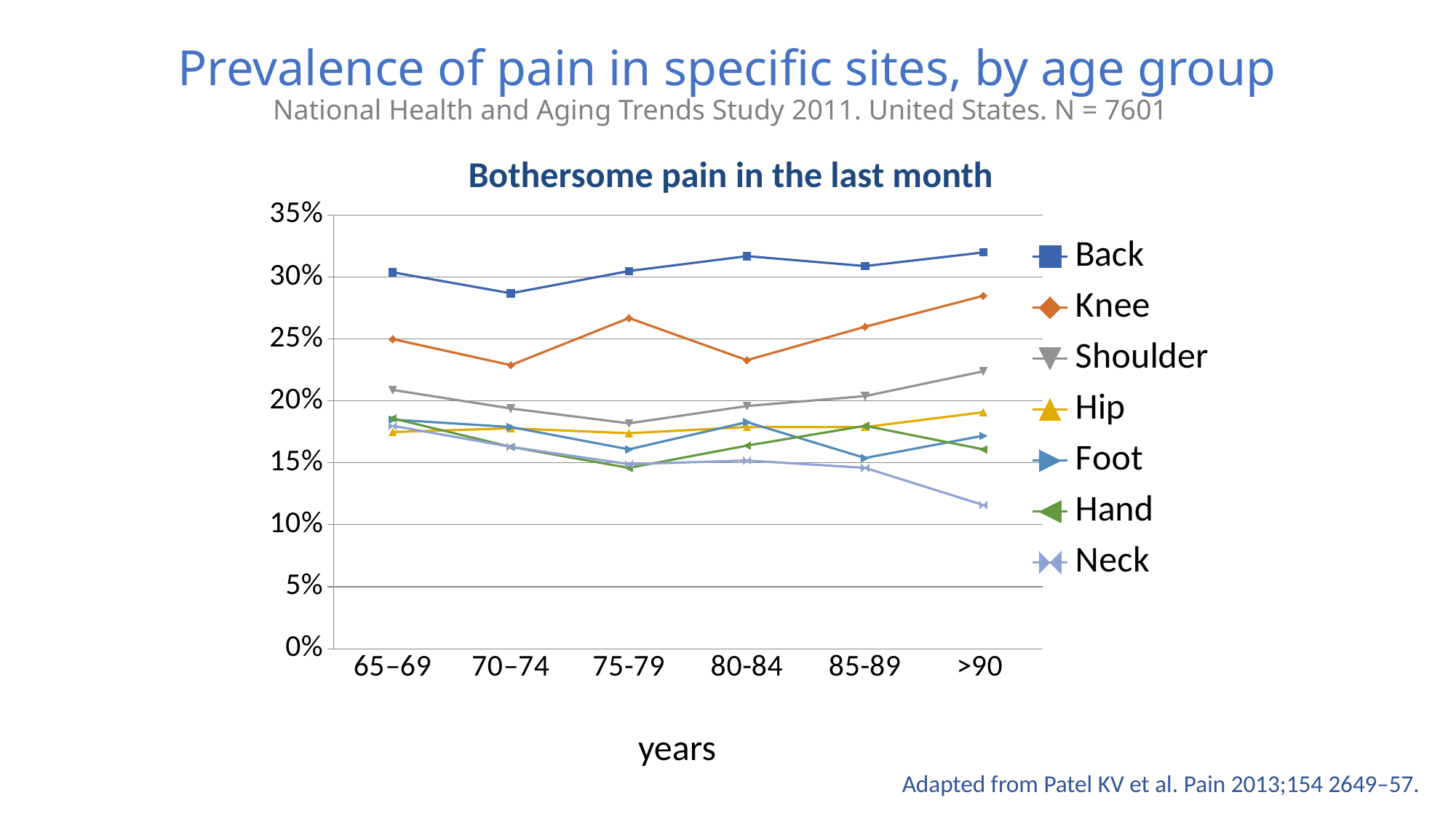
Which pain site has the highest prevalence in the 65–69 age group? Back How many series does the legend list? 7 Is the value for Neck in the >90 age group greater or less than 15%? less Is the value for Shoulder in the 75-79 age group greater or less than 20%? less Is the value for Back in the 70–74 age group greater or less than 30%? less In the 80-84 age group, which is larger, Knee or Shoulder? Knee How many age groups are shown on the x axis? 6 What is the title of the chart? Bothersome pain in the last month What kind of chart is shown on the slide? line chart Which pain site has the lowest prevalence in the >90 age group? Neck Does the Neck line rise or fall from the 80-84 age group to the >90 age group? fall